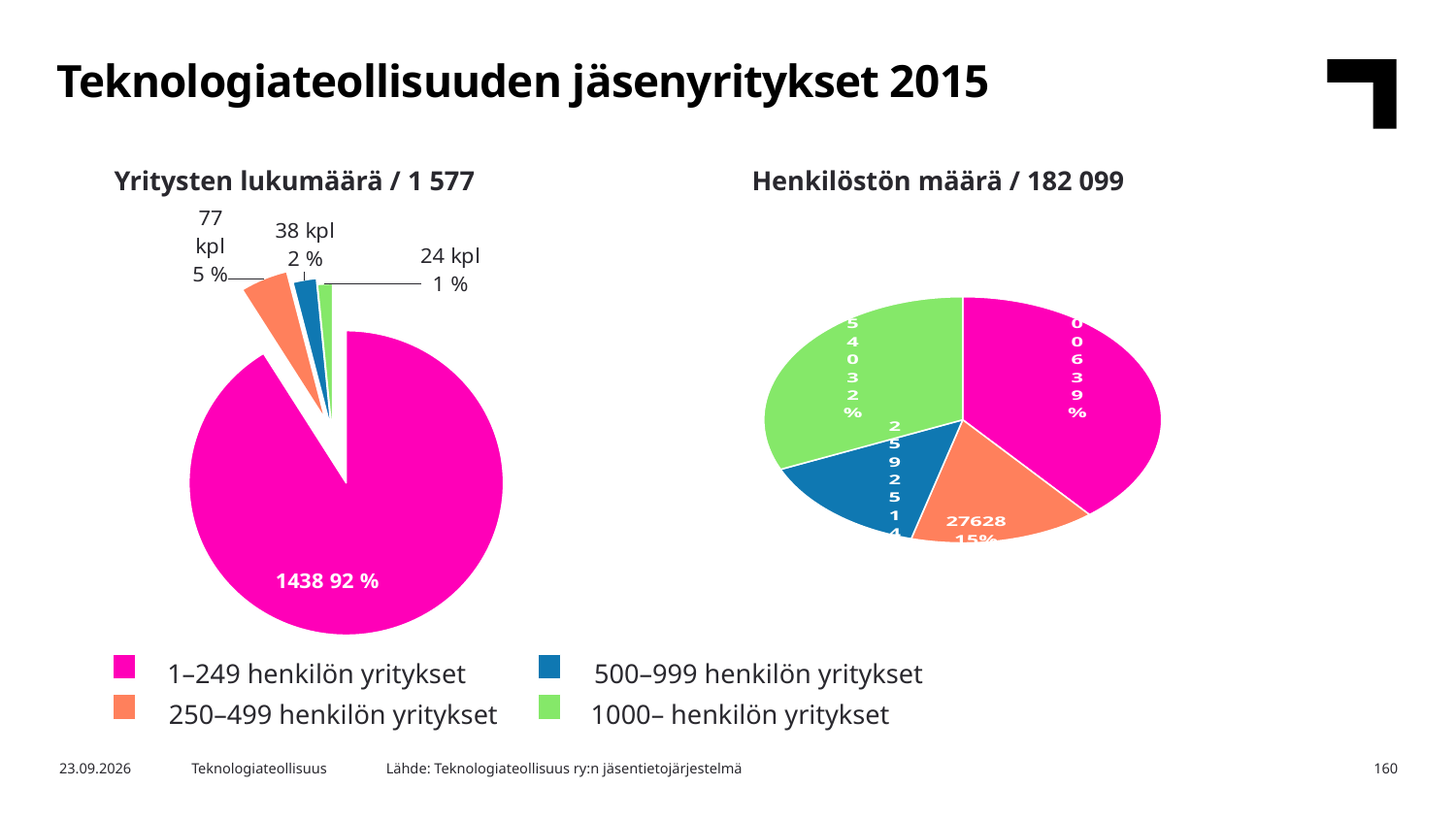
In the right chart 'Henkilöstön määrä / 182 099', which slice is larger: 1–249 henkilön yritykset or 250–499 henkilön yritykset? 1–249 henkilön yritykset In the left chart 'Yritysten lukumäärä / 1 577', how many companies are in the 1–249 henkilön yritykset category? 1438 In the left chart 'Yritysten lukumäärä / 1 577', what is the value for 1000– henkilön yritykset? 24 kpl In the left chart 'Yritysten lukumäärä / 1 577', which category has the largest slice? 1–249 henkilön yritykset In the left chart 'Yritysten lukumäärä / 1 577', which category has the smallest slice? 1000– henkilön yritykset What kind of chart is the left chart titled 'Yritysten lukumäärä / 1 577'? Pie chart How many categories does the legend list for the pie charts? 4 In the left chart 'Yritysten lukumäärä / 1 577', how many more companies are in the 250–499 category than in the 500–999 category? 39 In the left chart 'Yritysten lukumäärä / 1 577', what share does the 500–999 henkilön yritykset slice have? 2 % In the left chart 'Yritysten lukumäärä / 1 577', what share of the pie does the 1–249 henkilön yritykset slice have? 92 % In the right chart 'Henkilöstön määrä / 182 099', what is the value for 250–499 henkilön yritykset? 27628 In the left chart 'Yritysten lukumäärä / 1 577', what is the value for 250–499 henkilön yritykset? 77 kpl